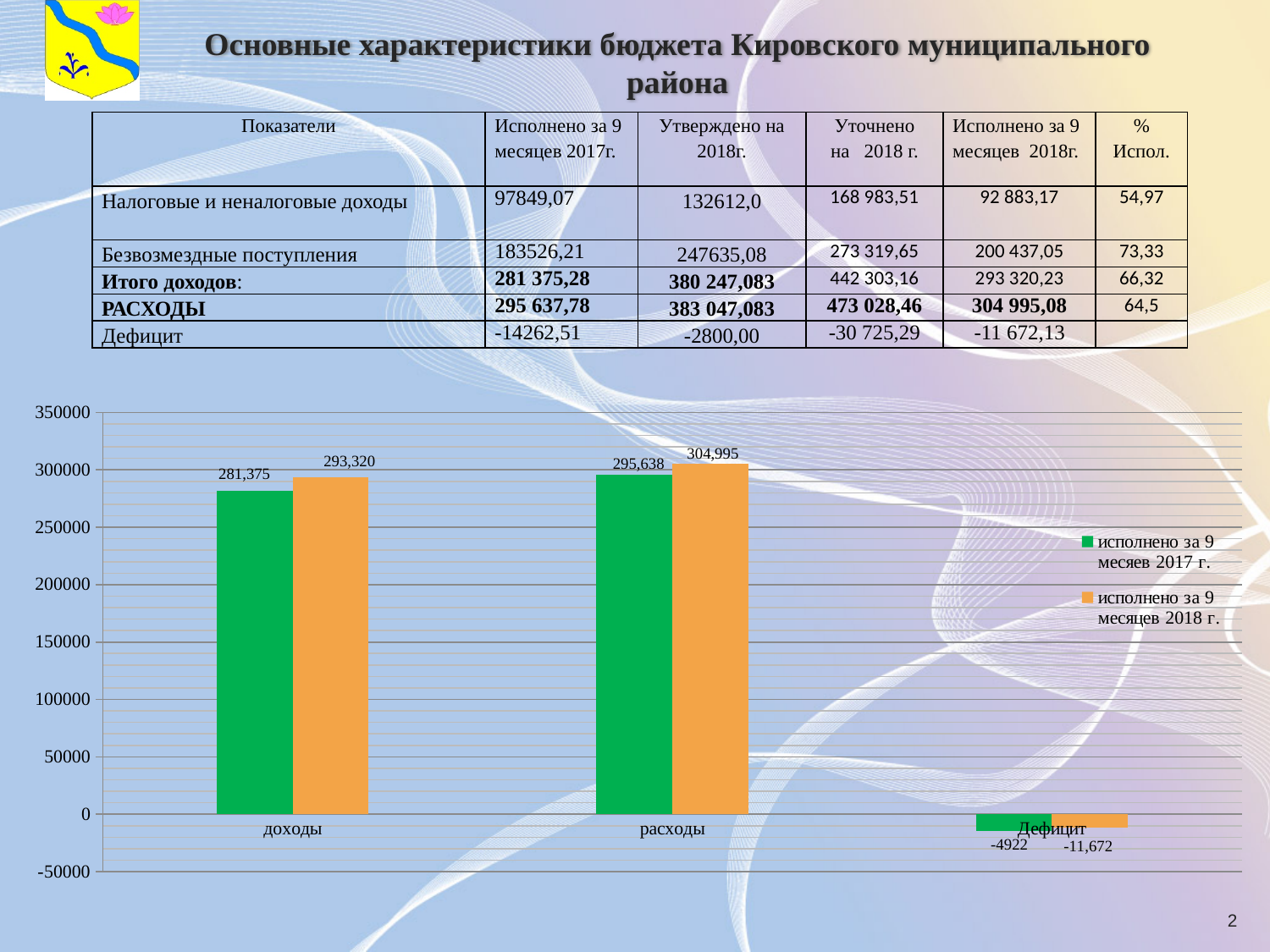
What is the value for доходы in the series 'исполнено за 9 месяцев 2018 г.'? 293,320 What kind of chart is shown on the slide? bar chart What is the value for расходы in the series 'исполнено за 9 месяев 2017 г.'? 295,638 How many categories are shown on the x axis of the chart? 3 How many series does the chart legend list? 2 Which category has the lowest value in the series 'исполнено за 9 месяев 2017 г.'? Дефицит Which category has the highest value in the series 'исполнено за 9 месяцев 2018 г.'? расходы What is the value for доходы in the series 'исполнено за 9 месяев 2017 г.'? 281,375 What is the value for Дефицит in the series 'исполнено за 9 месяцев 2018 г.'? -11,672 What is the difference between the 2018 and 2017 values for расходы? 9,357 What is the value for расходы in the series 'исполнено за 9 месяцев 2018 г.'? 304,995 Which colour represents the series 'исполнено за 9 месяцев 2018 г.' in the chart? orange